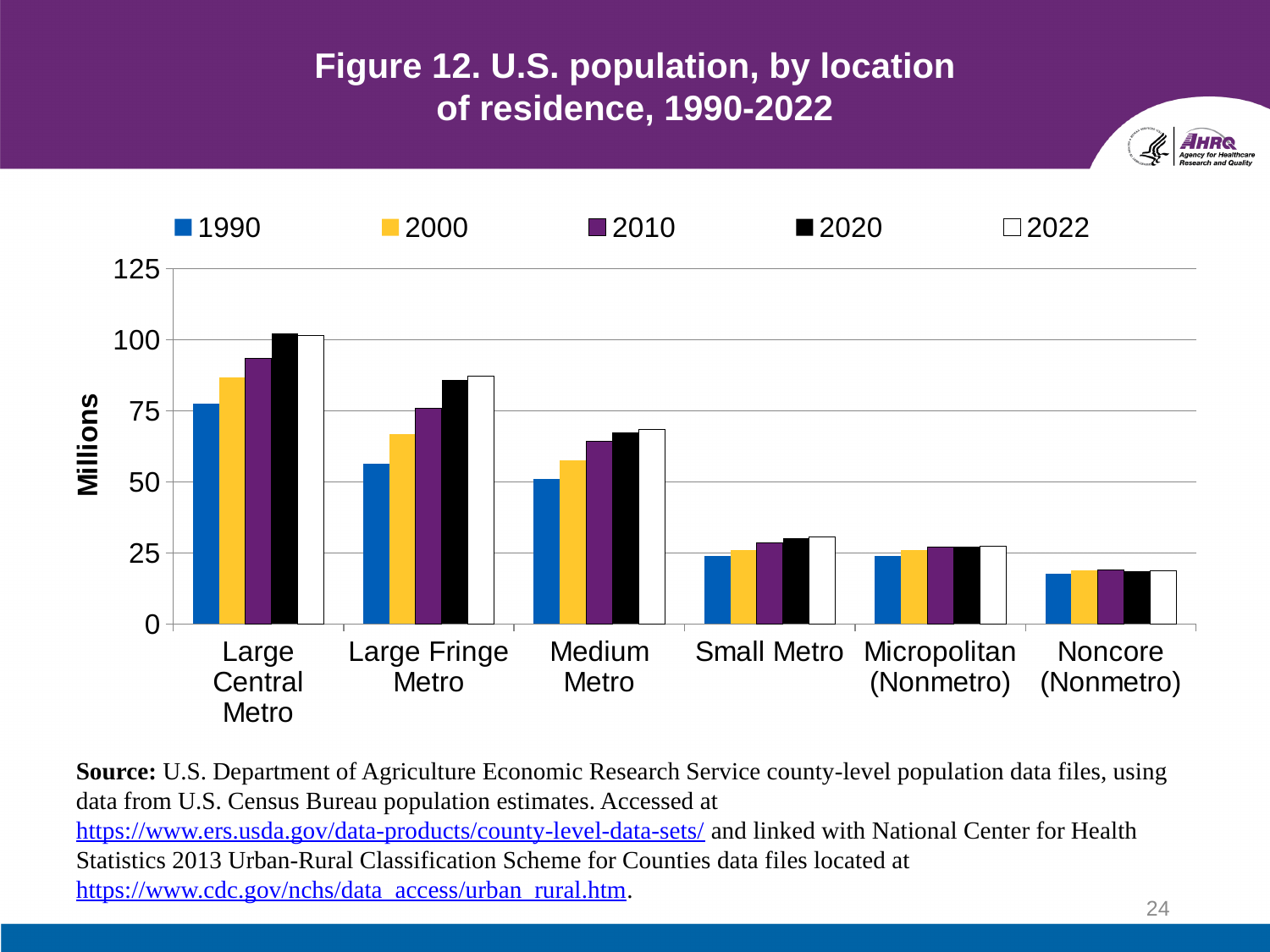
Which location of residence has the highest population in 2020? Large Central Metro Which location of residence has the lowest population in 1990? Noncore (Nonmetro) Is the 1990 value for Large Fringe Metro greater or less than 50? greater What kind of chart is shown on the slide? Bar chart How many series does the legend list? 5 Does the population of Large Fringe Metro rise or fall from 1990 to 2022? rise What is the label on the y axis? Millions Which is larger in 2022, the population of Large Fringe Metro or Medium Metro? Large Fringe Metro How many location-of-residence categories are shown on the x axis? 6 Is the 2022 value for Noncore (Nonmetro) greater or less than 25? less Is the 2022 value for Medium Metro greater or less than 75? less Which is larger in 2022, the population of Small Metro or Micropolitan (Nonmetro)? Small Metro